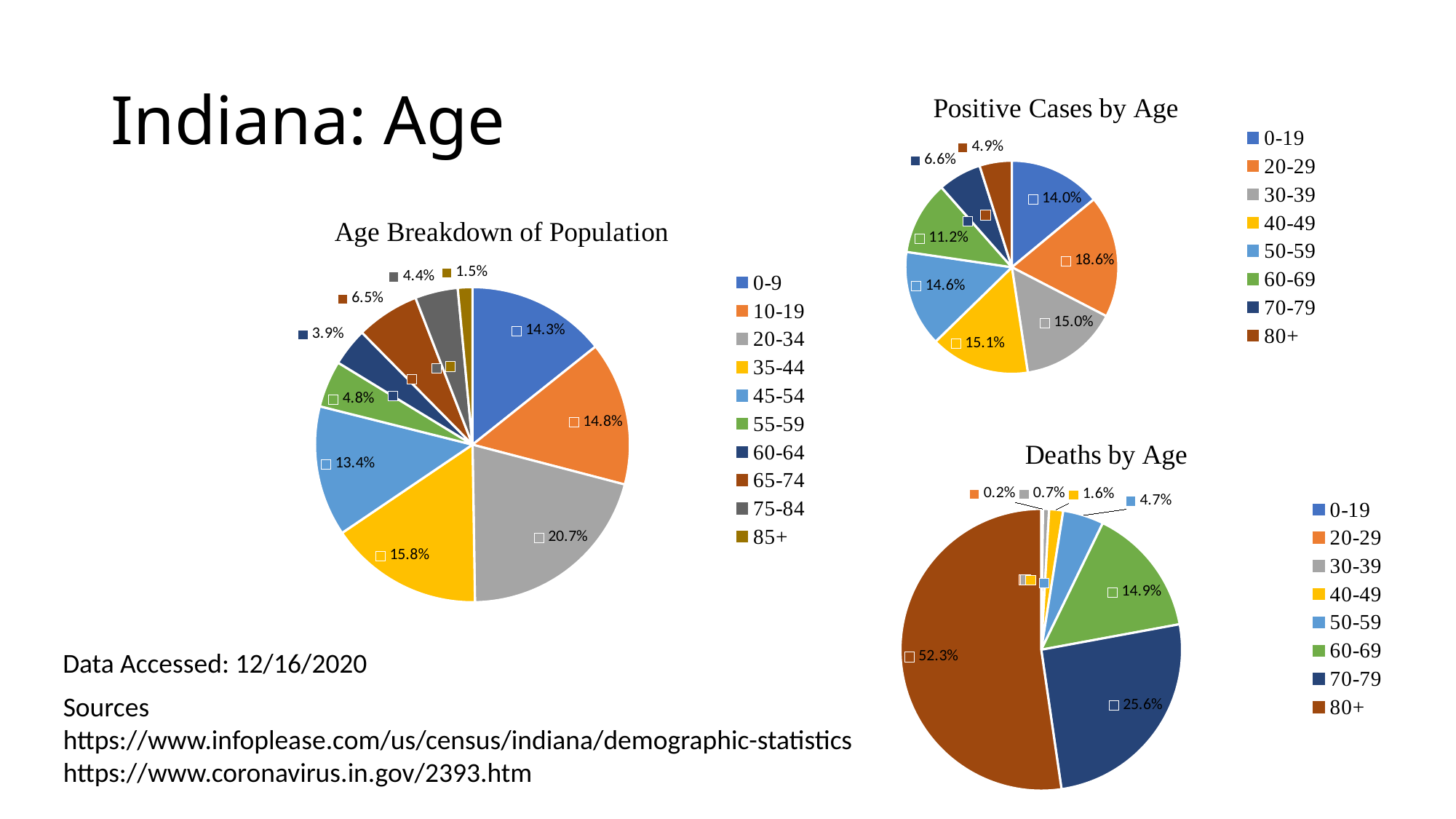
In the Positive Cases by Age chart, which is larger, the share for 60-69 or the share for 70-79? 60-69 In the Age Breakdown of Population chart, what is the difference between the 35-44 share and the 45-54 share? 2.4% In the Age Breakdown of Population chart, which age group has the smallest share? 85+ In the Deaths by Age chart, what is the difference between the 80+ share and the 70-79 share? 26.7% What type of chart is used for Deaths by Age? Pie chart In the Positive Cases by Age chart, which age group has the largest share of positive cases? 20-29 In the Age Breakdown of Population chart, what share of the population is aged 20-34? 20.7% How many charts are shown on the slide? 3 In the Age Breakdown of Population chart, how many age groups does the legend list? 10 In the Positive Cases by Age chart, what percentage of positive cases are in the 20-29 age group? 18.6% In the Positive Cases by Age chart, what is the combined share of the 70-79 and 80+ groups? 11.5% In the Deaths by Age chart, what percentage of deaths are in the 80+ age group? 52.3%